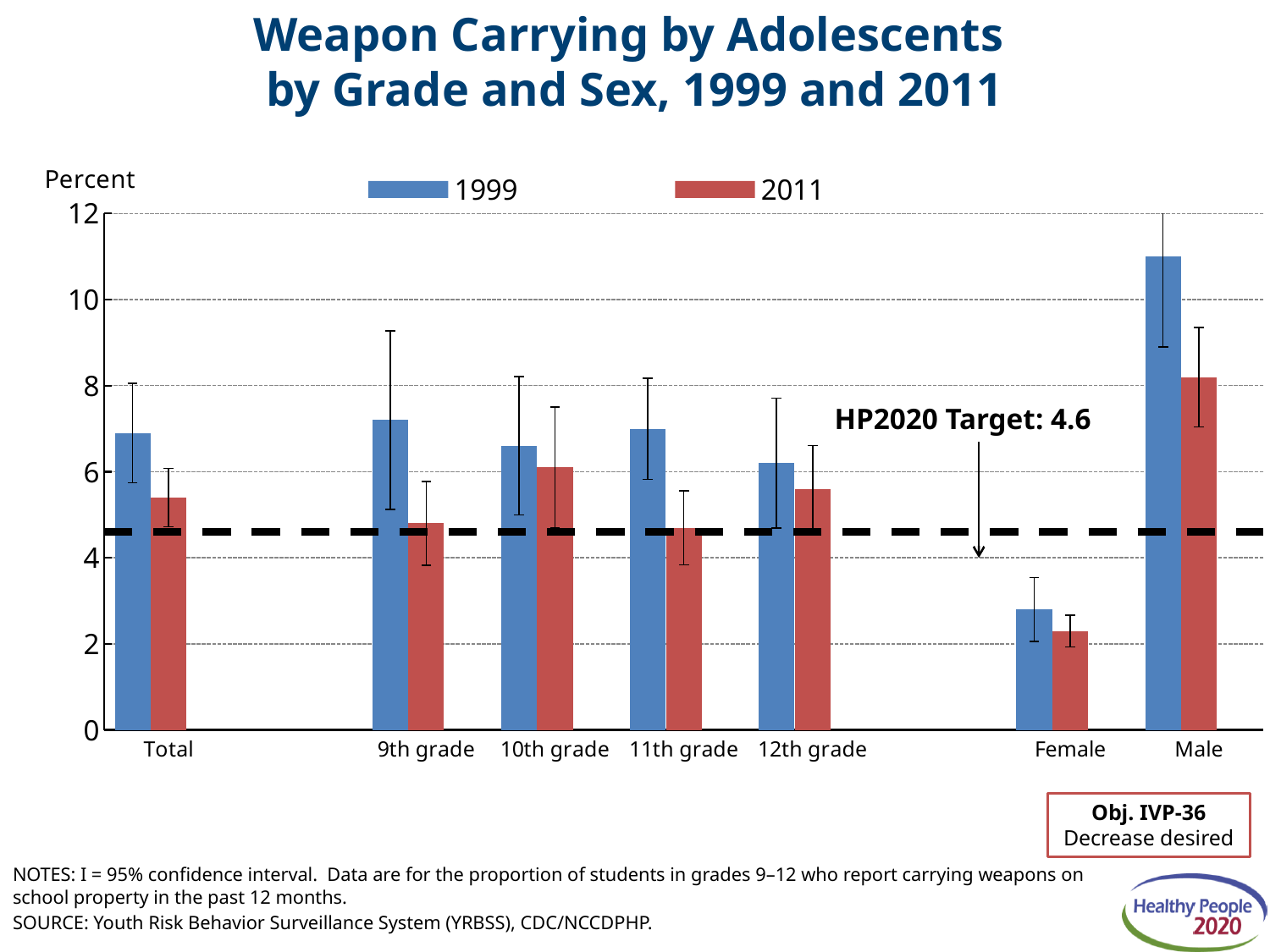
How many series does the legend list? 2 Which is larger, the 1999 value for Male or the 1999 value for Female? Male Which category has the highest 1999 value? Male What is the HP2020 Target value shown on the chart? 4.6 Is the 2011 value for 9th grade greater or less than 6? less Is the 2011 value for Female greater or less than 4? less How many categories are shown along the x axis? 7 What kind of chart is shown on the slide? bar chart Is the 1999 value for Male greater or less than 10? greater Which colour represents the 2011 series in the legend? red Which category has the lowest 2011 value? Female